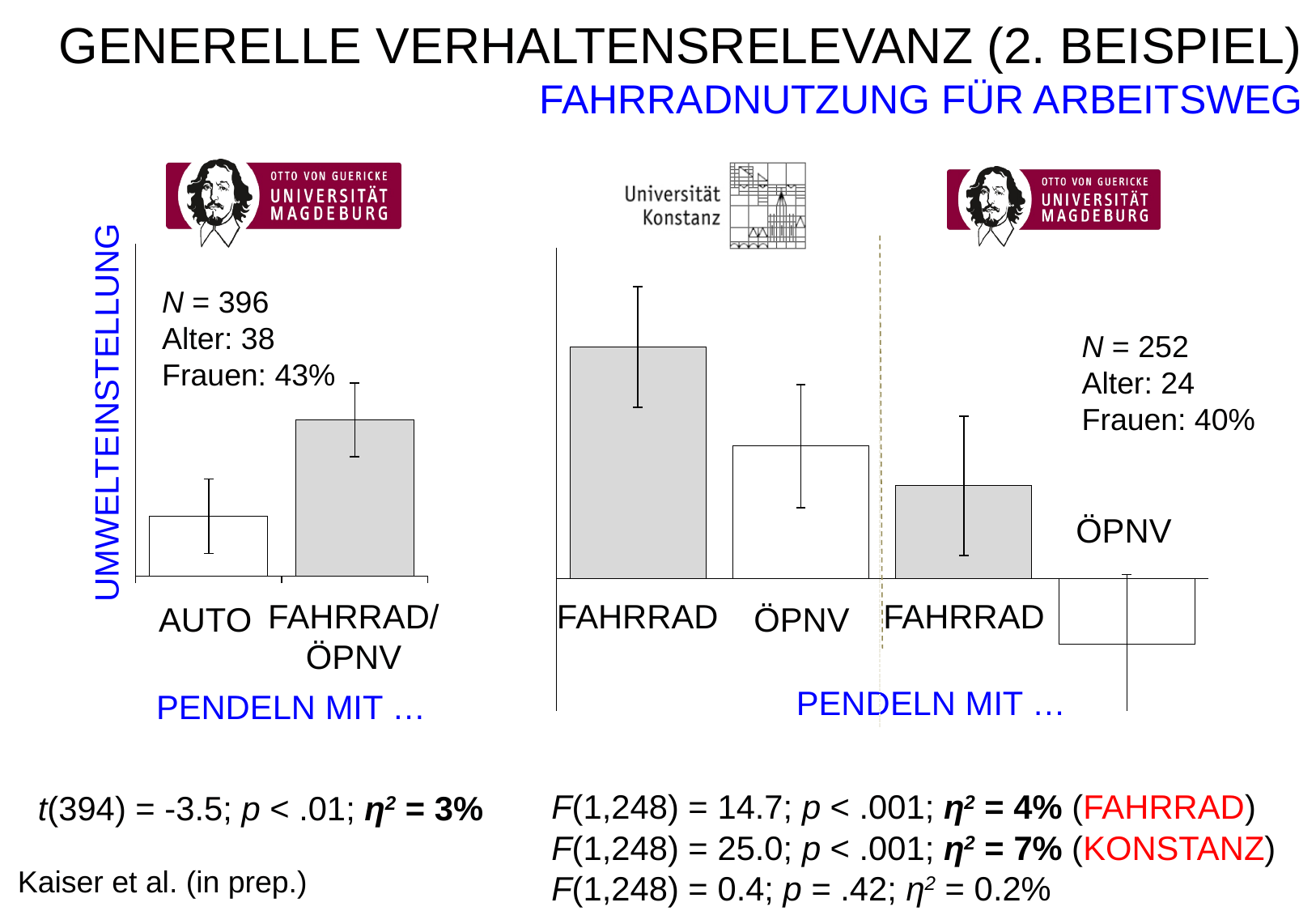
What is the y-axis label of the left chart? UMWELTEINSTELLUNG How many bars does the left chart (N = 396) show? 2 What kind of chart is the right chart (Universität Konstanz / Magdeburg)? bar chart What is the x-axis label shown under both charts? PENDELN MIT … In the right chart, for the Magdeburg sample (N = 252), which bar is higher, FAHRRAD or ÖPNV? FAHRRAD How many bars does the right chart show in total? 4 In the right chart, which bar is the highest? FAHRRAD (Universität Konstanz) In the right chart, for the Universität Konstanz sample, which bar is higher, FAHRRAD or ÖPNV? FAHRRAD In the right chart, which bar is the lowest? ÖPNV (Magdeburg, N = 252) In the left chart (N = 396), which category has the higher bar, AUTO or FAHRRAD/ÖPNV? FAHRRAD/ÖPNV What kind of chart is the left chart (N = 396)? bar chart In the left chart (N = 396), which category has the lowest bar? AUTO